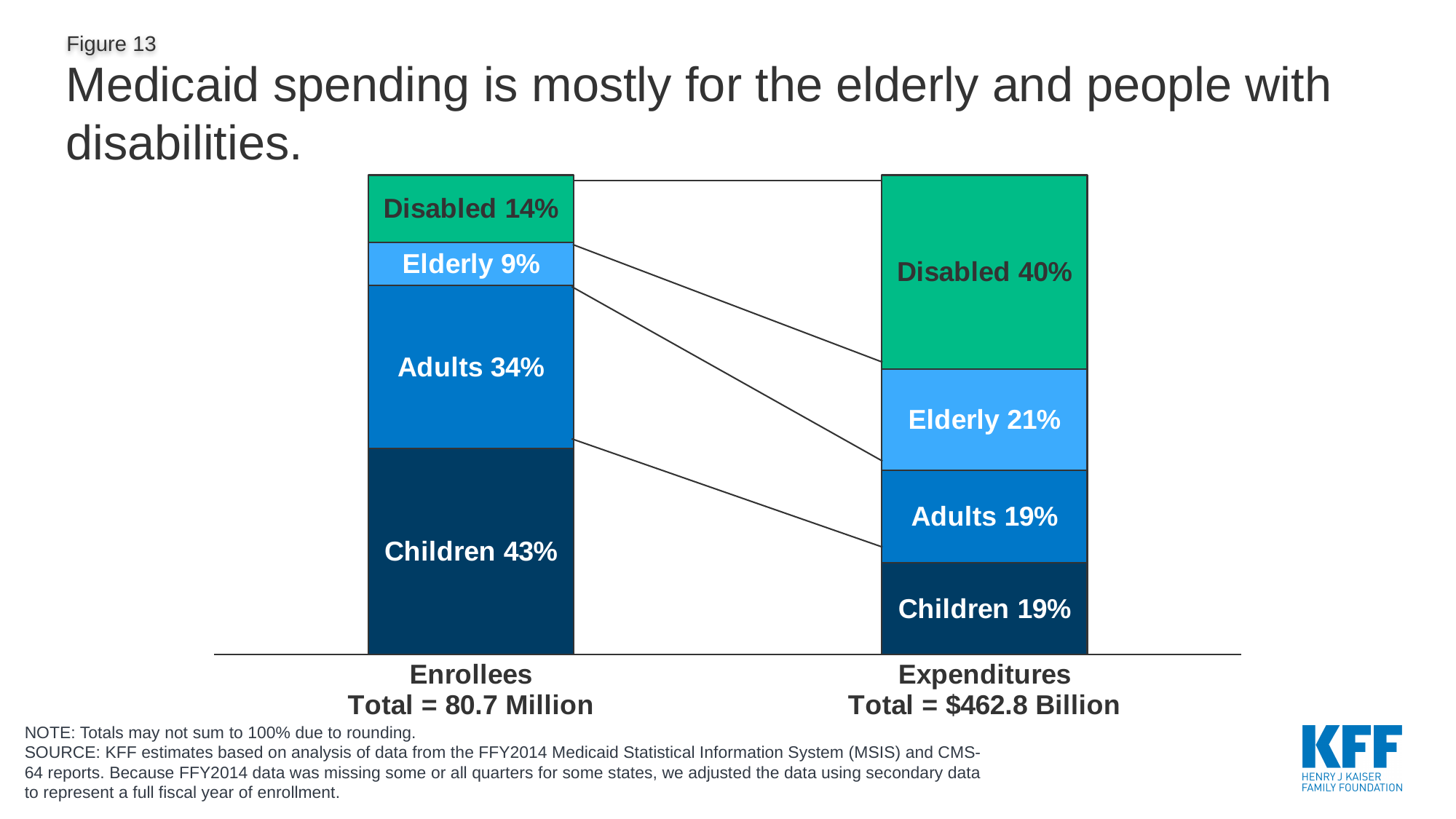
What is the total number of enrollees shown under the Enrollees bar? 80.7 Million What share of Medicaid expenditures goes to the elderly? 21% Which group makes up the largest share of enrollees? Children What type of chart is shown on the slide? Stacked bar chart How many groups are shown in each stacked bar? 4 What is the difference between the disabled share of expenditures and the disabled share of enrollees? 26 percentage points Which group accounts for the largest share of expenditures? Disabled Which group makes up the smallest share of enrollees? Elderly What share of Medicaid enrollees are children? 43% What share of Medicaid enrollees are elderly? 9% Which is larger: the adults' share of enrollees or the adults' share of expenditures? Adults' share of enrollees What share of Medicaid expenditures goes to the disabled? 40%